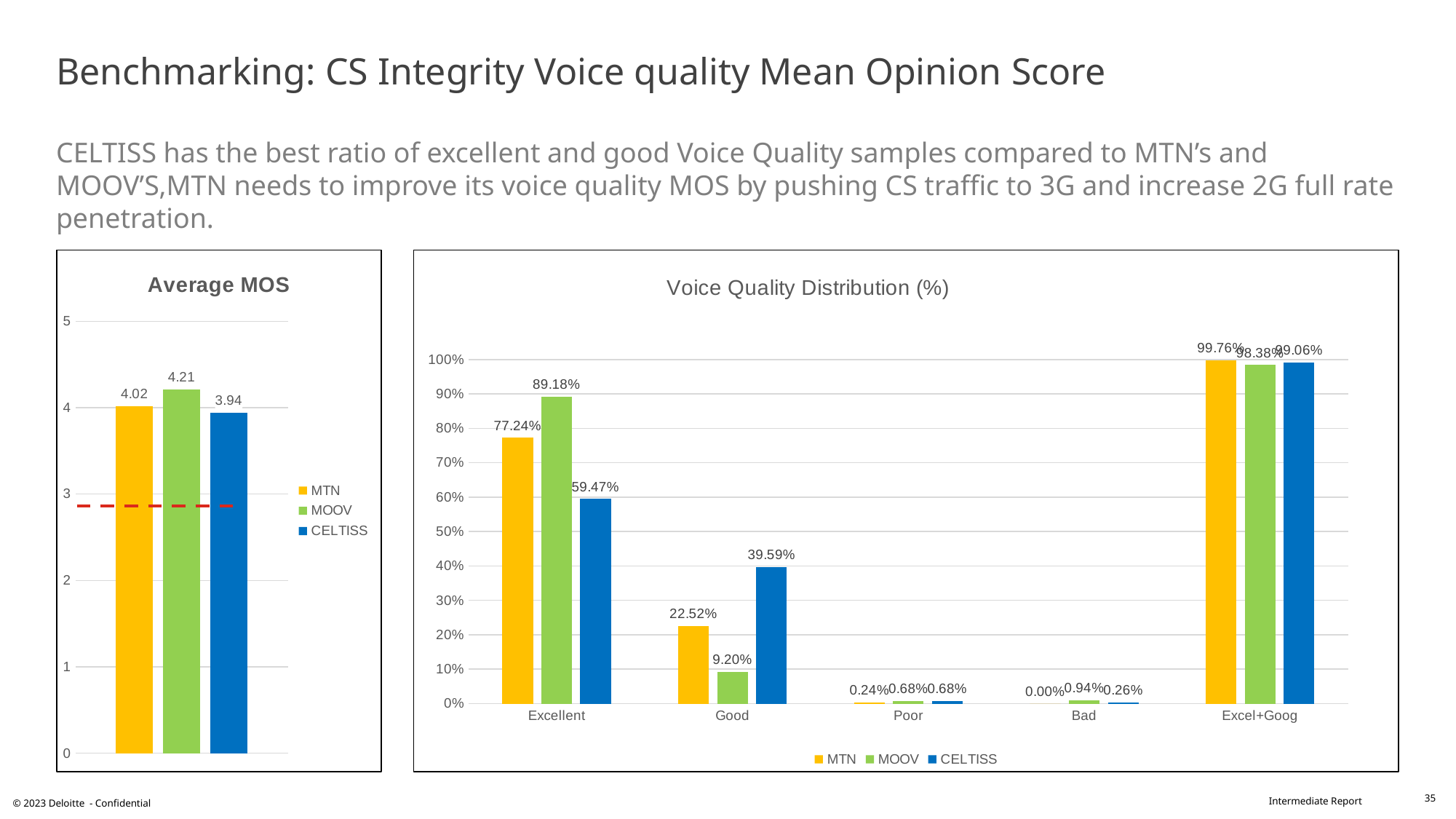
In the Voice Quality Distribution (%) chart, which operator has the highest value in the Excellent category? MOOV In the Voice Quality Distribution (%) chart, what is the value for MTN in the Bad category? 0.00% In the Average MOS chart, which operator has the lowest average MOS? CELTISS What kind of chart is the Voice Quality Distribution (%) chart? Bar chart In the Voice Quality Distribution (%) chart, what is the value for MTN in the Good category? 22.52% In the Average MOS chart, what is the value for MOOV? 4.21 In the Average MOS chart, what is the difference between MOOV's and CELTISS's values? 0.27 In the Voice Quality Distribution (%) chart, which is larger in the Good category: MOOV or CELTISS? CELTISS In the Voice Quality Distribution (%) chart, what is the difference between MTN's and MOOV's values in the Excellent category? 11.94% In the Voice Quality Distribution (%) chart, how many categories are shown on the x axis? 5 In the Average MOS chart, how many series does the legend list? 3 In the Voice Quality Distribution (%) chart, what is the value for CELTISS in the Excellent category? 59.47%